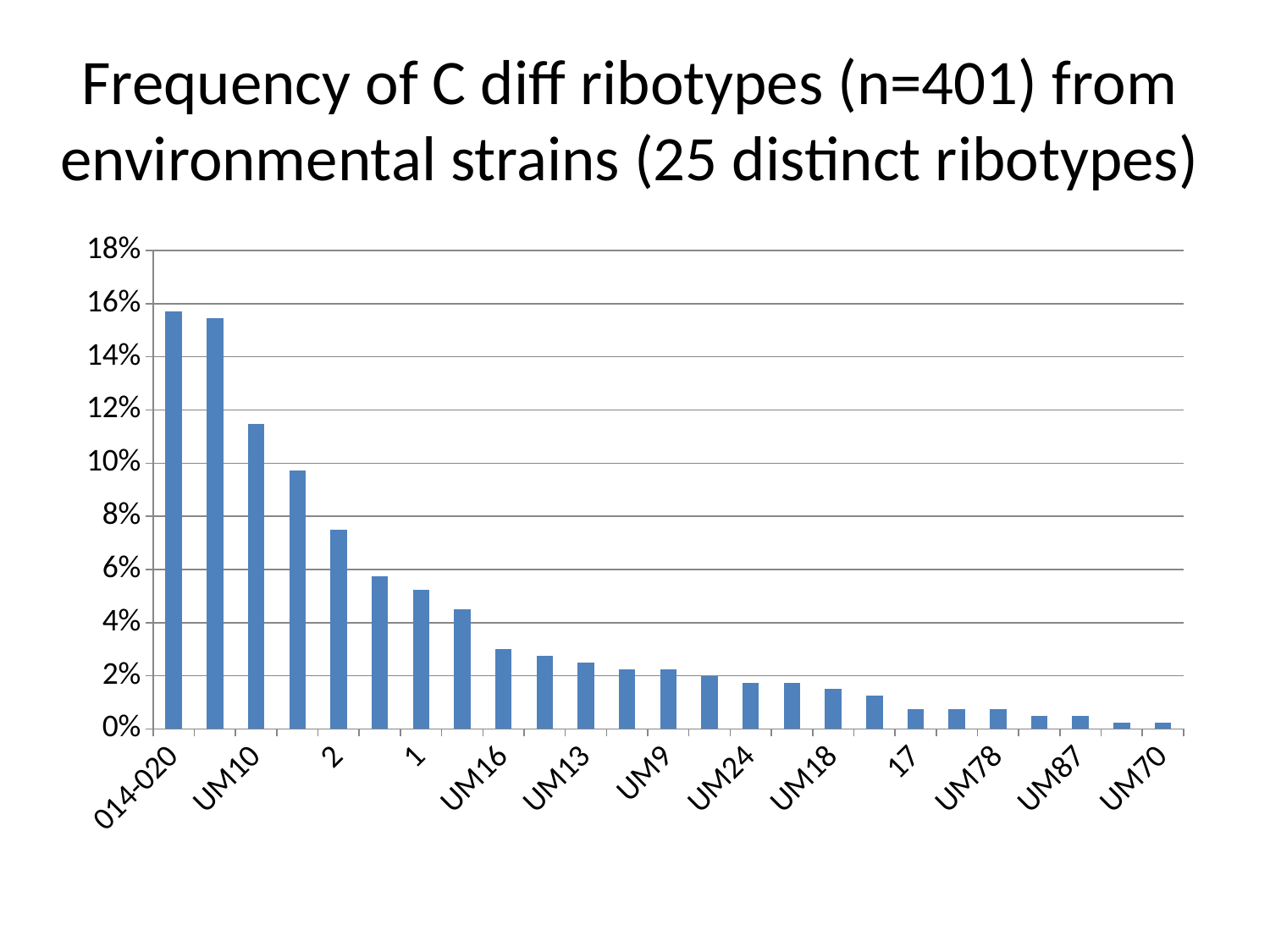
Is the value for UM10 greater or less than 10%? greater What is the highest value shown on the y axis? 18% Is the value for ribotype 1 greater or less than 4%? greater How many bars (ribotypes) are plotted in the chart? 25 Do the bar values rise or fall from left to right along the x axis? fall Is the value for UM16 greater or less than 4%? less Which has the larger value, UM16 or UM9? UM16 What kind of chart is shown on the slide? bar chart Which has the larger value, UM10 or ribotype 2? UM10